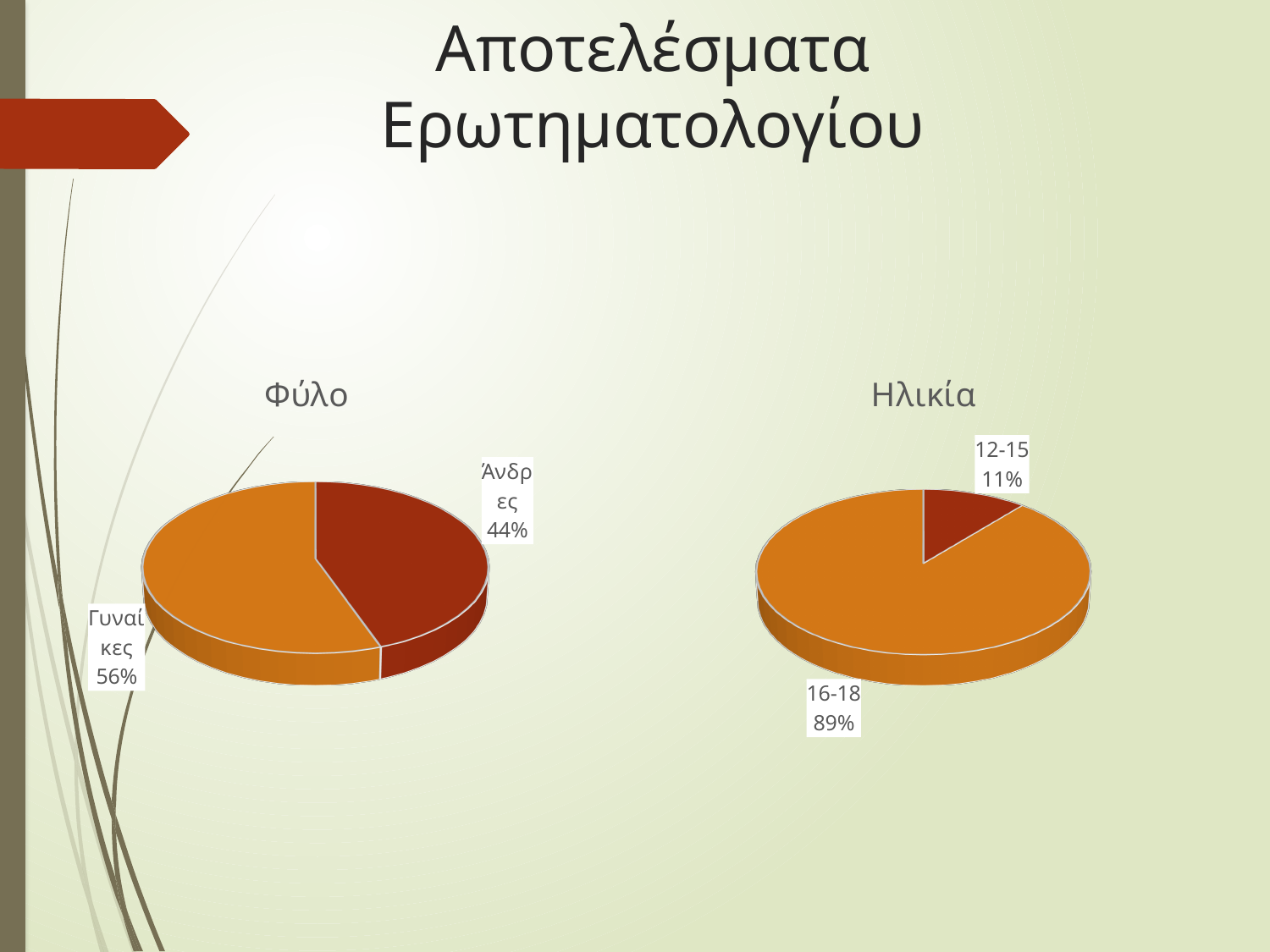
In the "Ηλικία" pie chart, which slice is the smallest? 12-15 In the "Ηλικία" pie chart, what is the difference in percentage points between the 16-18 and 12-15 groups? 78 How many slices does the "Φύλο" pie chart have? 2 What is the title of the chart on the left of the slide? Φύλο In the "Φύλο" pie chart, what is the difference in percentage points between Γυναίκες and Άνδρες? 12 In the "Φύλο" pie chart, what share is labelled for Άνδρες? 44% In the "Φύλο" pie chart, which slice is the largest? Γυναίκες In the "Ηλικία" pie chart, what share is labelled for the 16-18 group? 89% In the "Ηλικία" pie chart, which is larger: the 12-15 slice or the 16-18 slice? 16-18 What type of chart is the "Ηλικία" chart? Pie chart In the "Φύλο" pie chart, what share is labelled for Γυναίκες? 56%